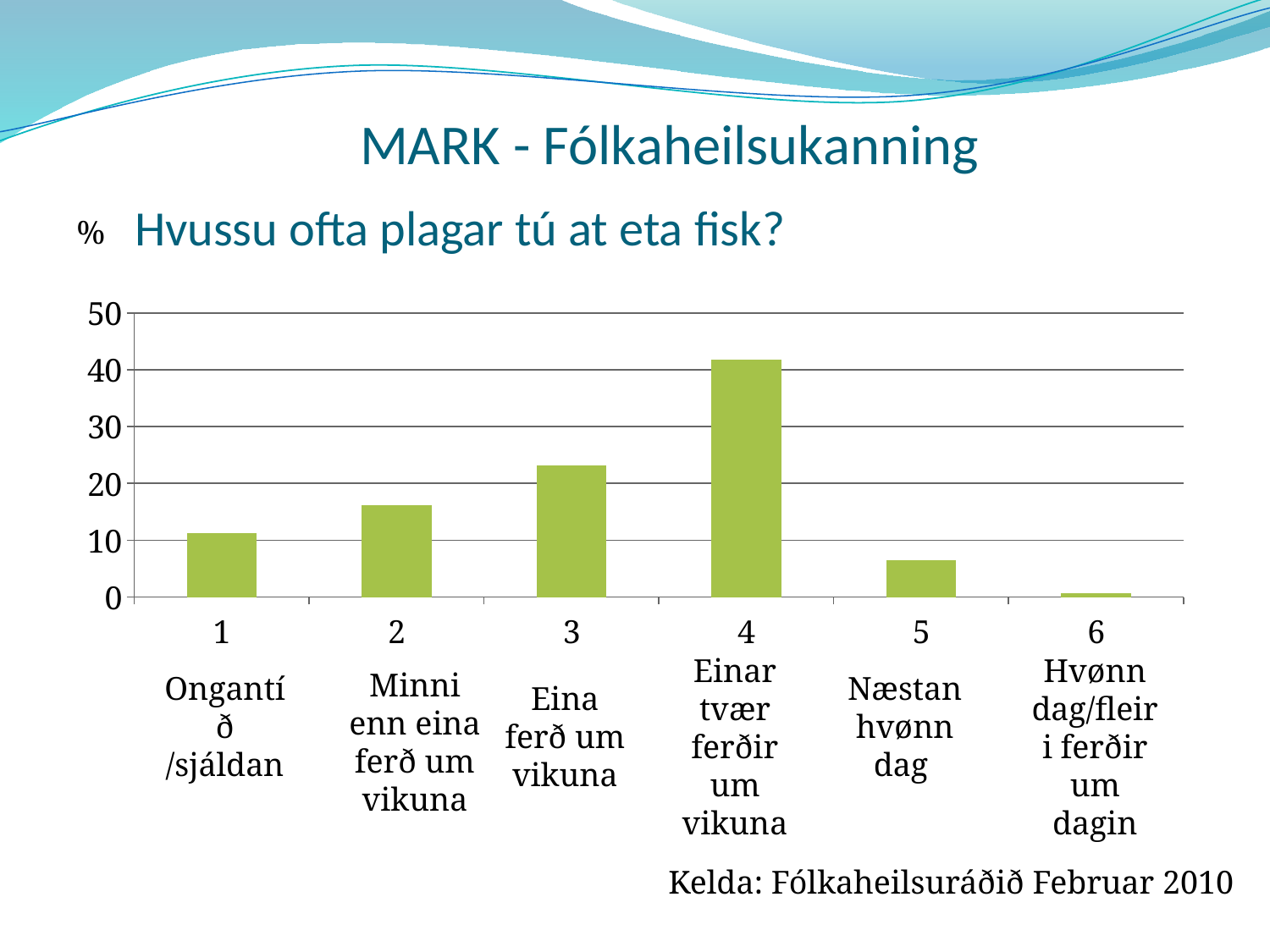
Is the value for category 3 (Eina ferð um vikuna) greater or less than 20? greater Is the value for category 4 (Einar tvær ferðir um vikuna) greater or less than 40? greater Is the value for category 1 (Ongantíð/sjáldan) greater or less than 20? less Which category has the lowest bar? 6 (Hvønn dag/fleiri ferðir um dagin) What kind of chart is shown on the slide? bar chart Which category has the highest bar? 4 (Einar tvær ferðir um vikuna) Which is larger, the value for category 3 (Eina ferð um vikuna) or category 2 (Minni enn eina ferð um vikuna)? category 3 (Eina ferð um vikuna) What question does the chart title ask? Hvussu ofta plagar tú at eta fisk? What is the source cited below the chart? Fólkaheilsuráðið Februar 2010 How many categories are shown on the x axis of the chart? 6